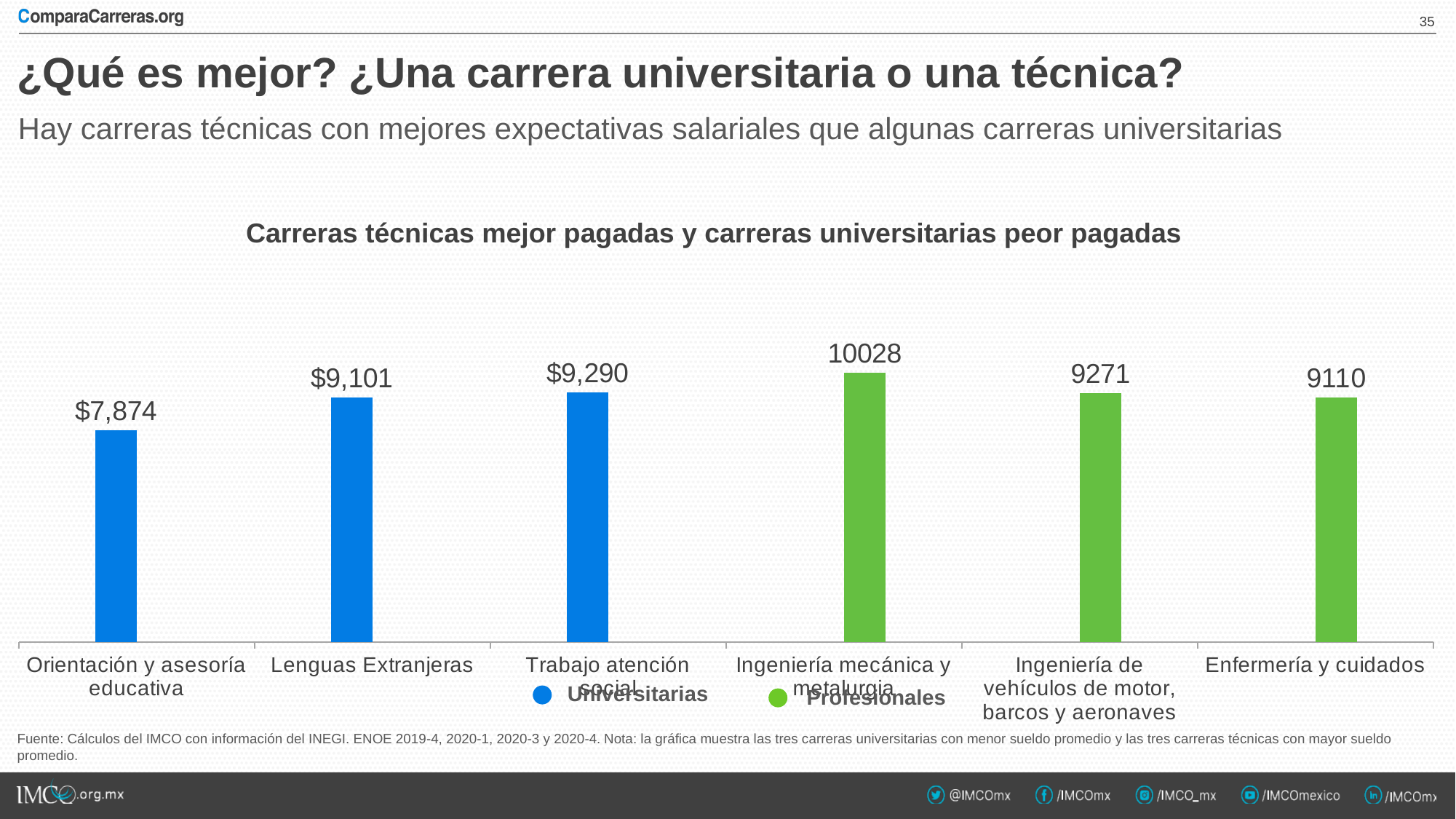
What is the difference between the values for Trabajo atención social and Lenguas Extranjeras? 189 What is the value shown for Orientación y asesoría educativa? $7,874 What is the difference between the values for Ingeniería mecánica y metalurgia and Ingeniería de vehículos de motor, barcos y aeronaves? 757 What is the value shown for Lenguas Extranjeras? $9,101 How many series does the legend list? 2 How many categories are shown on the chart? 6 What is the value shown for Enfermería y cuidados? 9110 Which is larger, the value for Trabajo atención social or the value for Enfermería y cuidados? Trabajo atención social Which category has the highest value? Ingeniería mecánica y metalurgia What is the value shown for Ingeniería mecánica y metalurgia? 10028 What kind of chart is shown on the slide? Bar chart Which category has the lowest value? Orientación y asesoría educativa